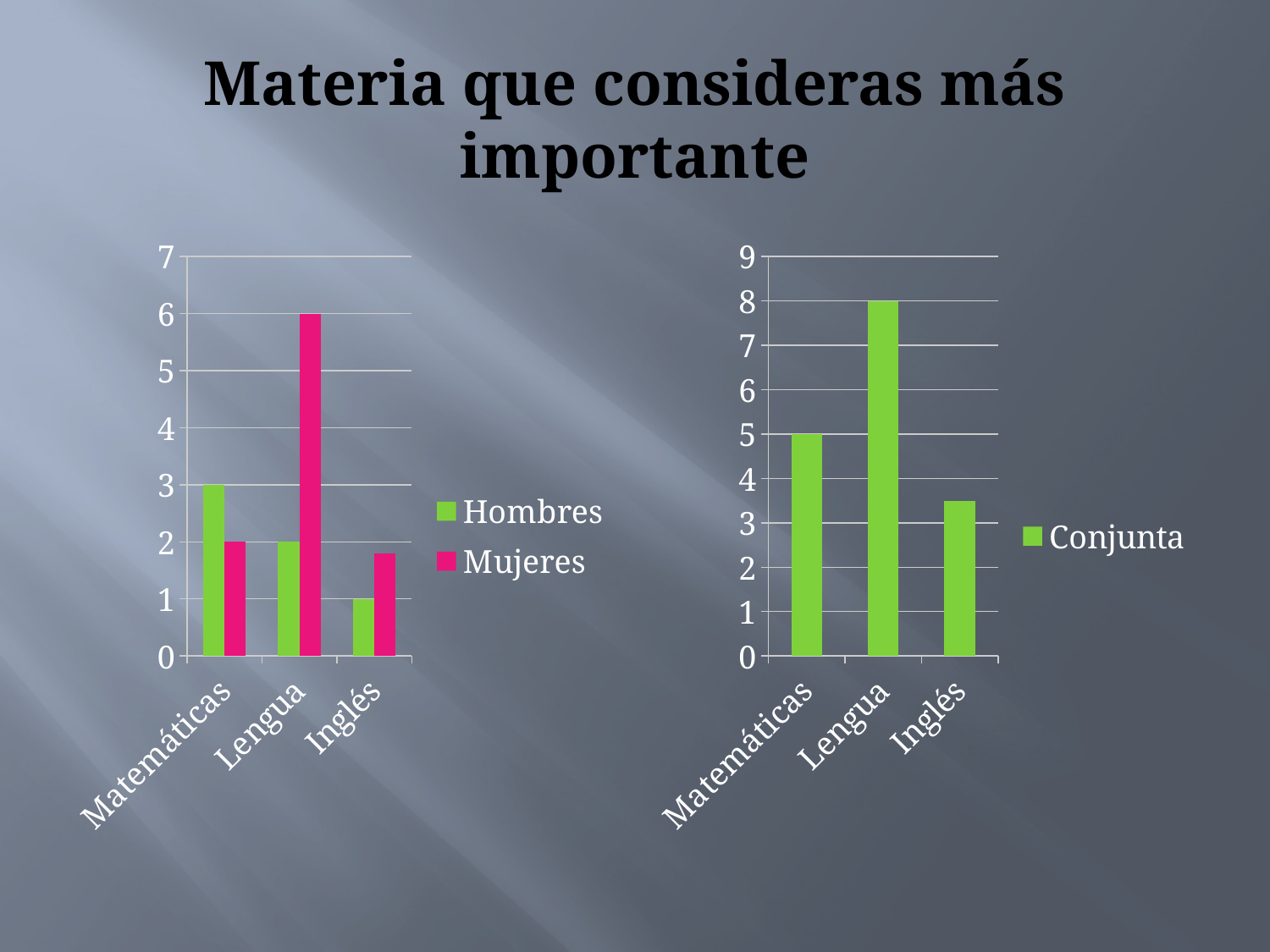
In the left chart, what is the value for Hombres in Matemáticas? 3 In the left chart, is the value for Mujeres in Inglés greater or less than 1? greater In the left chart, what is the difference between Mujeres and Hombres in Lengua? 4 In the right chart, what is the Conjunta value for Lengua? 8 In the right chart, is the Conjunta value for Inglés greater or less than 4? less In the left chart, what is the value for Mujeres in Lengua? 6 In the right chart, what is the Conjunta value for Matemáticas? 5 How many series does the legend of the left chart list? 2 In the left chart, what is the value for Hombres in Inglés? 1 In the left chart, which category has the highest value for Mujeres? Lengua In the left chart, which category has the lowest value for Hombres? Inglés In the left chart, which is larger in Matemáticas, Hombres or Mujeres? Hombres